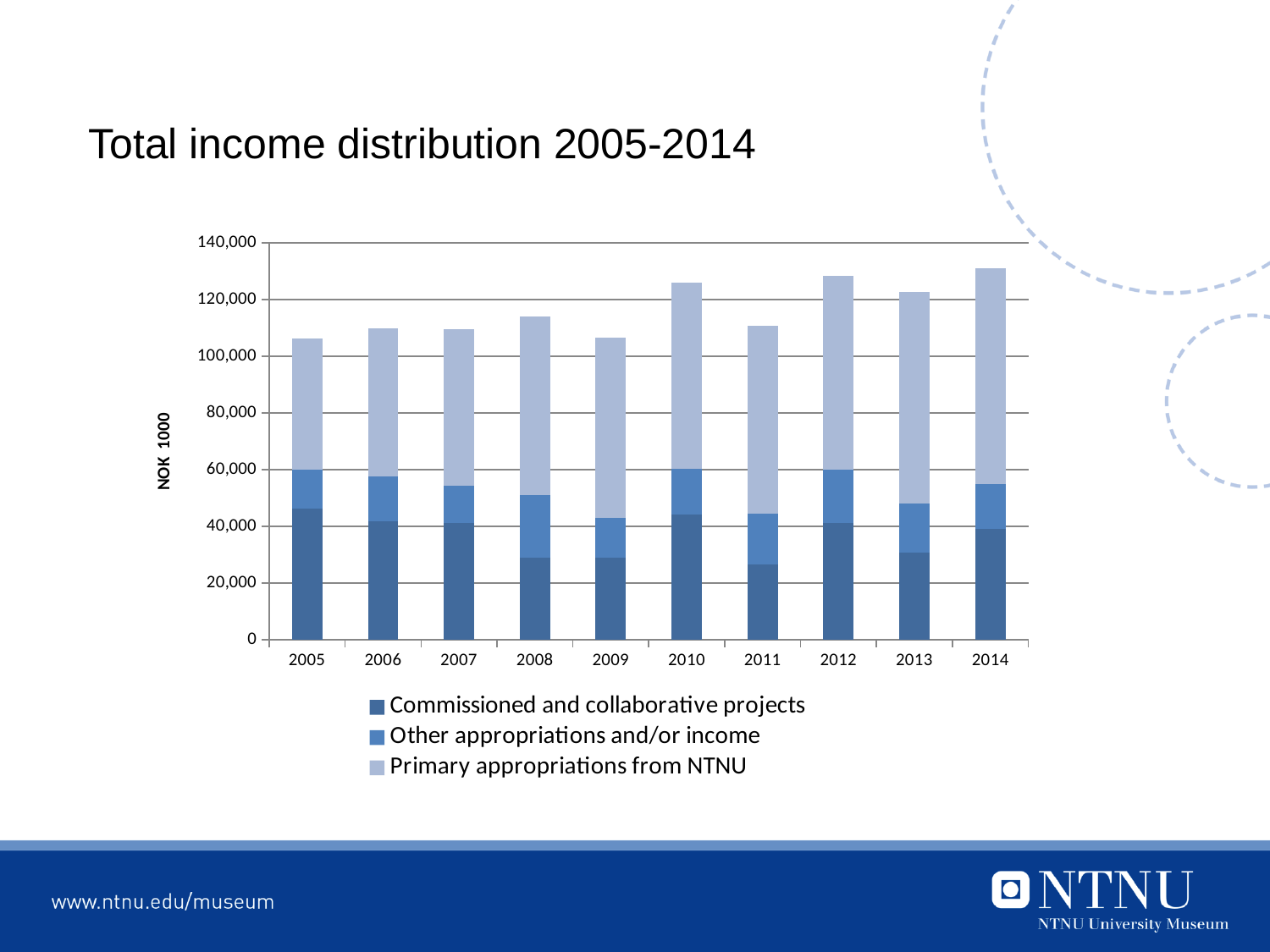
Is the value for Commissioned and collaborative projects in 2011 greater or less than 40,000? less How many series does the chart's legend list? 3 What is the title of the chart on the slide? Total income distribution 2005-2014 Is the value for Commissioned and collaborative projects in 2005 greater or less than 40,000? greater Is the total value of the stacked bar for 2008 greater or less than 120,000? less Which year has the larger value for Commissioned and collaborative projects, 2005 or 2008? 2005 Overall, do the total stacked bar heights rise or fall from 2005 to 2014? rise What is the label on the vertical axis of the chart? NOK 1000 What kind of chart is shown on the slide? Stacked bar chart Which year has the larger total stacked bar, 2009 or 2010? 2010 How many years are shown on the x axis of the chart? 10